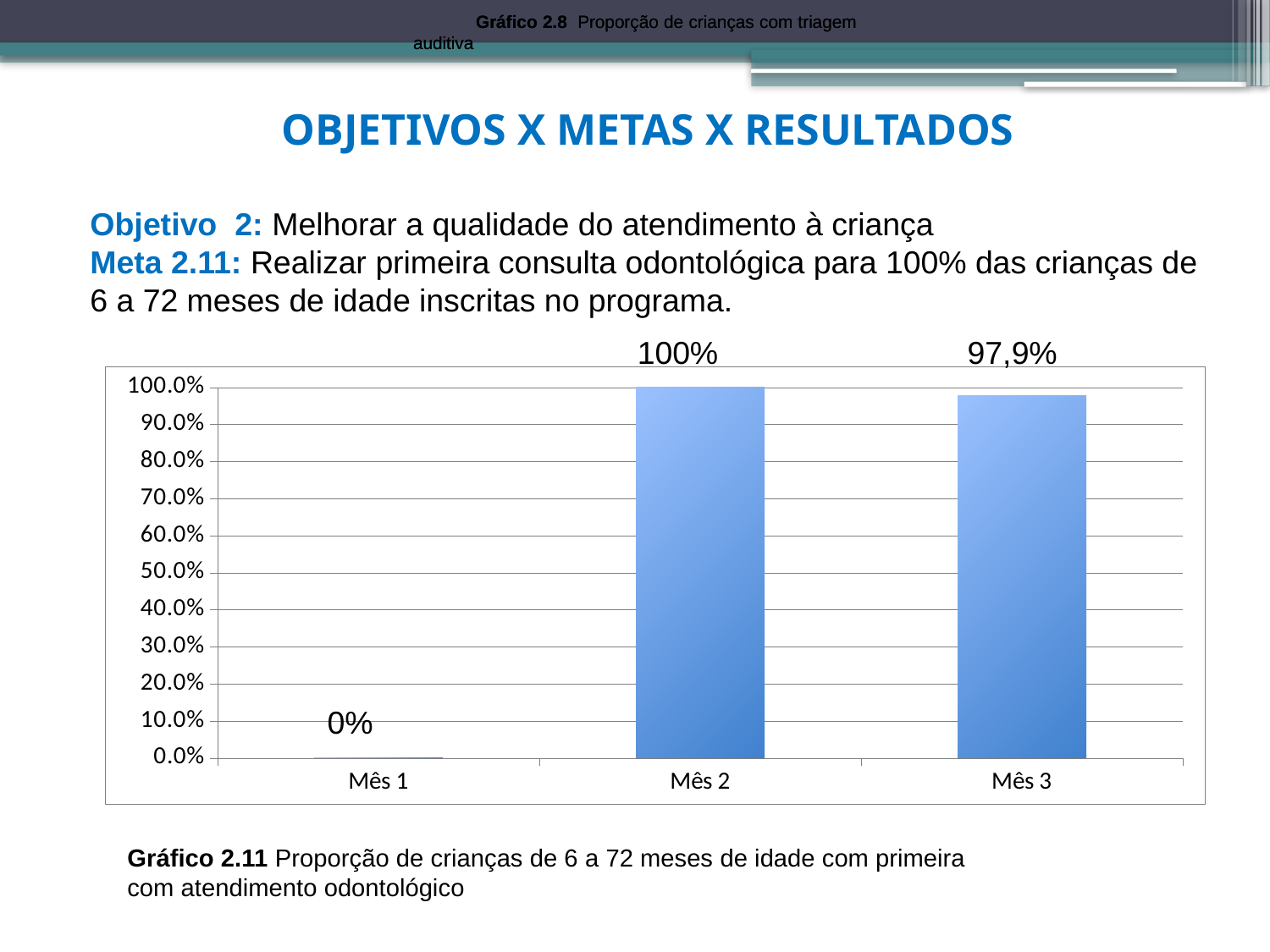
What is the difference between the values for Mês 2 and Mês 3? 2,1% Does the value rise or fall from Mês 1 to Mês 2? rise What kind of chart is shown on the slide? bar chart What is the caption number of the chart shown below the plot? Gráfico 2.11 Which month has the highest value? Mês 2 Which month has the lowest value? Mês 1 Which is larger, the value for Mês 2 or the value for Mês 3? Mês 2 What is the value for Mês 1? 0% What is the value for Mês 2? 100% How many months are shown on the x axis? 3 Is the value for Mês 3 greater or less than 90.0%? greater What is the value for Mês 3? 97,9%